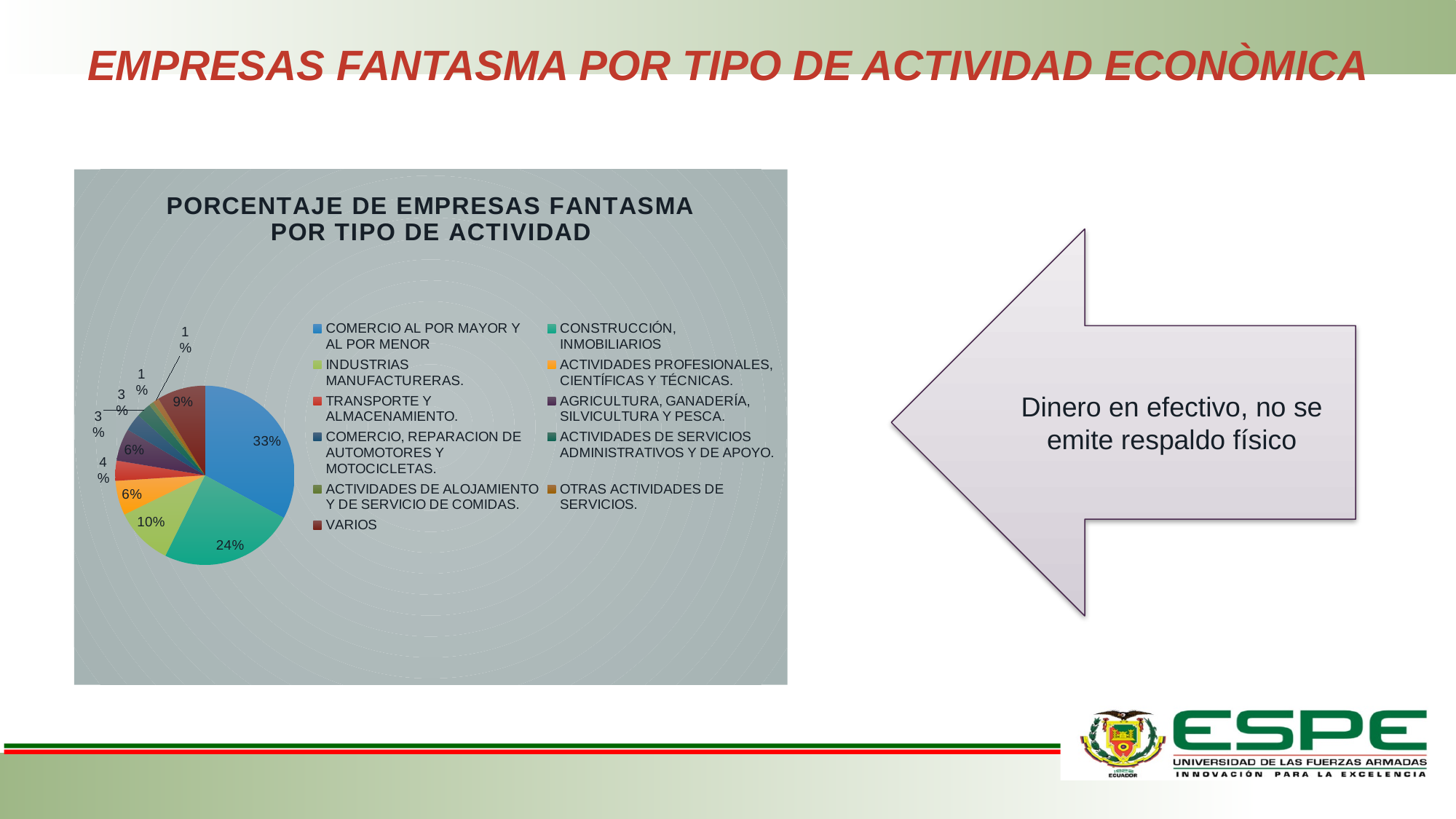
What is the combined share of the two largest slices, COMERCIO AL POR MAYOR Y AL POR MENOR and CONSTRUCCIÓN, INMOBILIARIOS? 57% What percentage is shown for COMERCIO AL POR MAYOR Y AL POR MENOR? 33% What percentage is shown for VARIOS? 9% What percentage is shown for INDUSTRIAS MANUFACTURERAS? 10% What is the difference in percentage points between COMERCIO AL POR MAYOR Y AL POR MENOR and CONSTRUCCIÓN, INMOBILIARIOS? 9 percentage points What percentage is shown for CONSTRUCCIÓN, INMOBILIARIOS? 24% What kind of chart is shown on the slide? pie chart What is the title of the chart? PORCENTAJE DE EMPRESAS FANTASMA POR TIPO DE ACTIVIDAD Which is larger, the slice for CONSTRUCCIÓN, INMOBILIARIOS or the slice for INDUSTRIAS MANUFACTURERAS? CONSTRUCCIÓN, INMOBILIARIOS How many categories does the legend of the pie chart list? 11 What colour is the slice for COMERCIO AL POR MAYOR Y AL POR MENOR? blue Which category has the largest slice of the pie? COMERCIO AL POR MAYOR Y AL POR MENOR